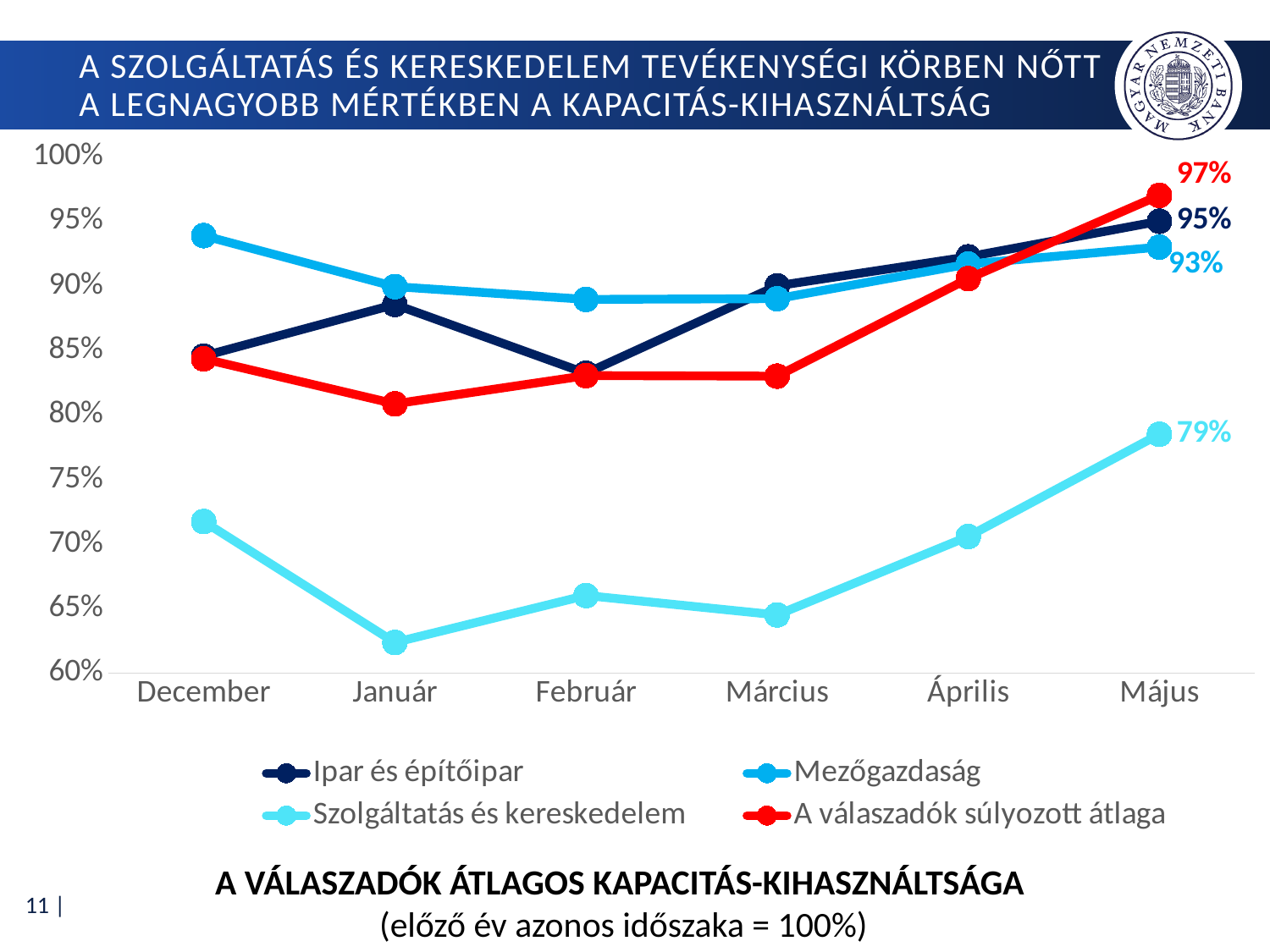
What is the difference between the Május values of A válaszadók súlyozott átlaga and Szolgáltatás és kereskedelem? 18 percentage points How many months are shown on the x axis? 6 What is the value for Mezőgazdaság in Május? 93% What is the value for A válaszadók súlyozott átlaga in Május? 97% What is the value for Szolgáltatás és kereskedelem in Május? 79% What is the value for Ipar és építőipar in Május? 95% How many series does the legend list? 4 Which series has the lowest value in Május? Szolgáltatás és kereskedelem In Május, which is larger: Ipar és építőipar or Mezőgazdaság? Ipar és építőipar Is the value for Szolgáltatás és kereskedelem in Január greater or less than 65%? less What kind of chart is shown on the slide? line chart Which series has the highest value in Május? A válaszadók súlyozott átlaga